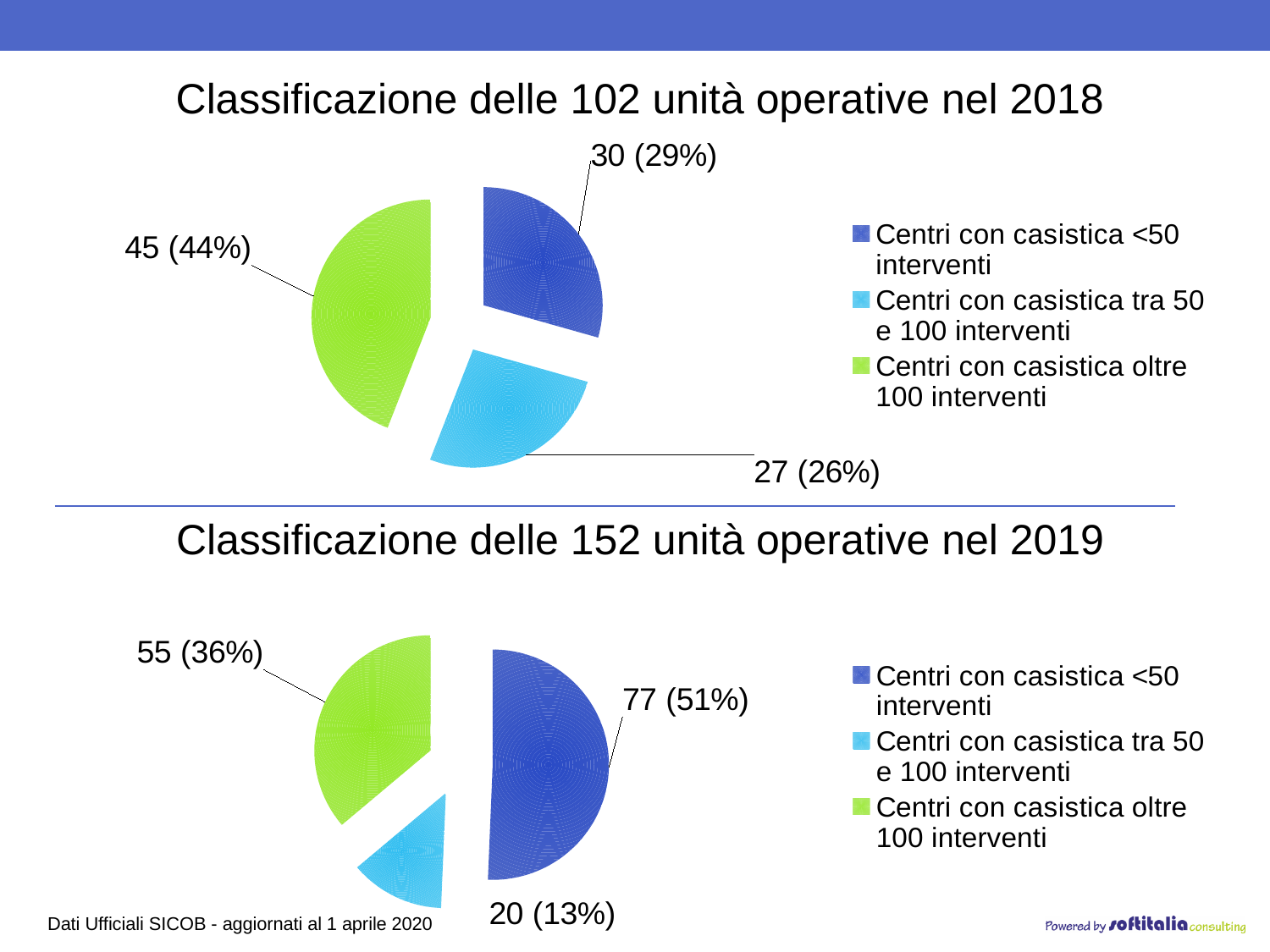
In the 2019 chart (bottom), which is larger: the slice for 'Centri con casistica <50 interventi' or the slice for 'Centri con casistica oltre 100 interventi'? Centri con casistica <50 interventi In the 2018 chart (top), how many units are in the category 'Centri con casistica oltre 100 interventi'? 45 (44%) In the 2019 chart (bottom), what is the difference between the number of units with casistica <50 interventi and those with casistica tra 50 e 100 interventi? 57 In the 2018 chart (top), what share of the pie does 'Centri con casistica tra 50 e 100 interventi' represent? 26% In the 2019 chart (bottom), which category has the smallest slice? Centri con casistica tra 50 e 100 interventi What is the title of the top chart? Classificazione delle 102 unità operative nel 2018 In the 2019 chart (bottom), how many units are in the category 'Centri con casistica <50 interventi'? 77 (51%) In the 2018 chart (top), which category has the largest slice? Centri con casistica oltre 100 interventi What type of chart is used in the 2019 chart (bottom)? Pie chart In the 2018 chart (top), what is the difference between the number of units with casistica oltre 100 interventi and those with casistica <50 interventi? 15 How many categories does the 2018 chart (top) show? 3 In the 2019 chart (bottom), what share of the pie does 'Centri con casistica oltre 100 interventi' represent? 36%